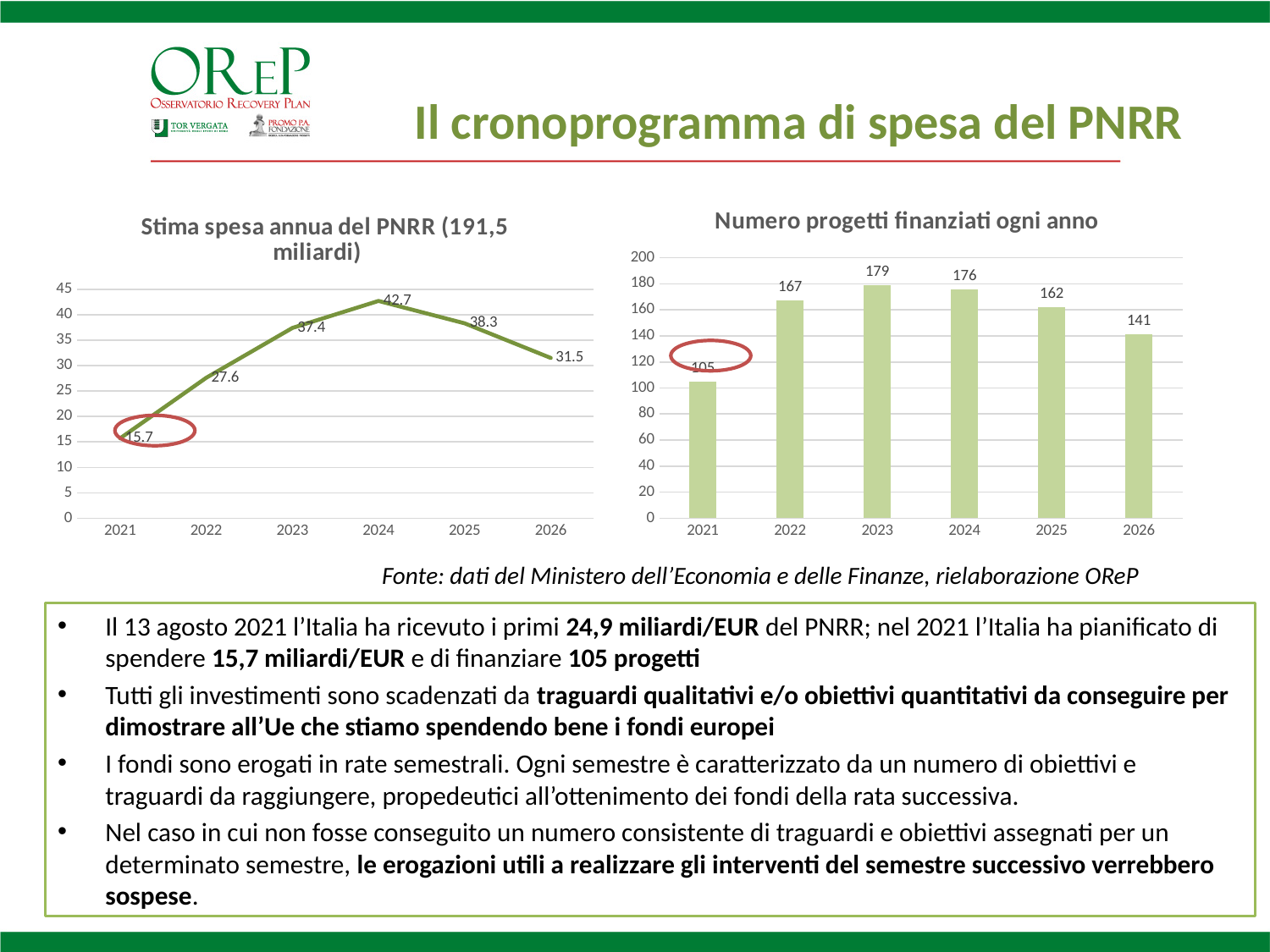
In the chart 'Numero progetti finanziati ogni anno', how many years are shown on the x axis? 6 In the chart 'Numero progetti finanziati ogni anno', what is the value for 2023? 179 In the chart 'Numero progetti finanziati ogni anno', which is larger, the value for 2022 or the value for 2025? 2022 In the chart 'Stima spesa annua del PNRR (191,5 miliardi)', what is the value for 2024? 42.7 In the chart 'Stima spesa annua del PNRR (191,5 miliardi)', what kind of chart is shown? Line chart In the chart 'Stima spesa annua del PNRR (191,5 miliardi)', do the values rise or fall from 2024 to 2026? Fall In the chart 'Stima spesa annua del PNRR (191,5 miliardi)', what is the difference between the values for 2024 and 2021? 27 In the chart 'Stima spesa annua del PNRR (191,5 miliardi)', what is the value for 2021? 15.7 In the chart 'Numero progetti finanziati ogni anno', which year has the lowest number of projects? 2021 In the chart 'Stima spesa annua del PNRR (191,5 miliardi)', which year has the highest value? 2024 In the chart 'Stima spesa annua del PNRR (191,5 miliardi)', which year has the lowest value? 2021 In the chart 'Numero progetti finanziati ogni anno', what is the value for 2026? 141